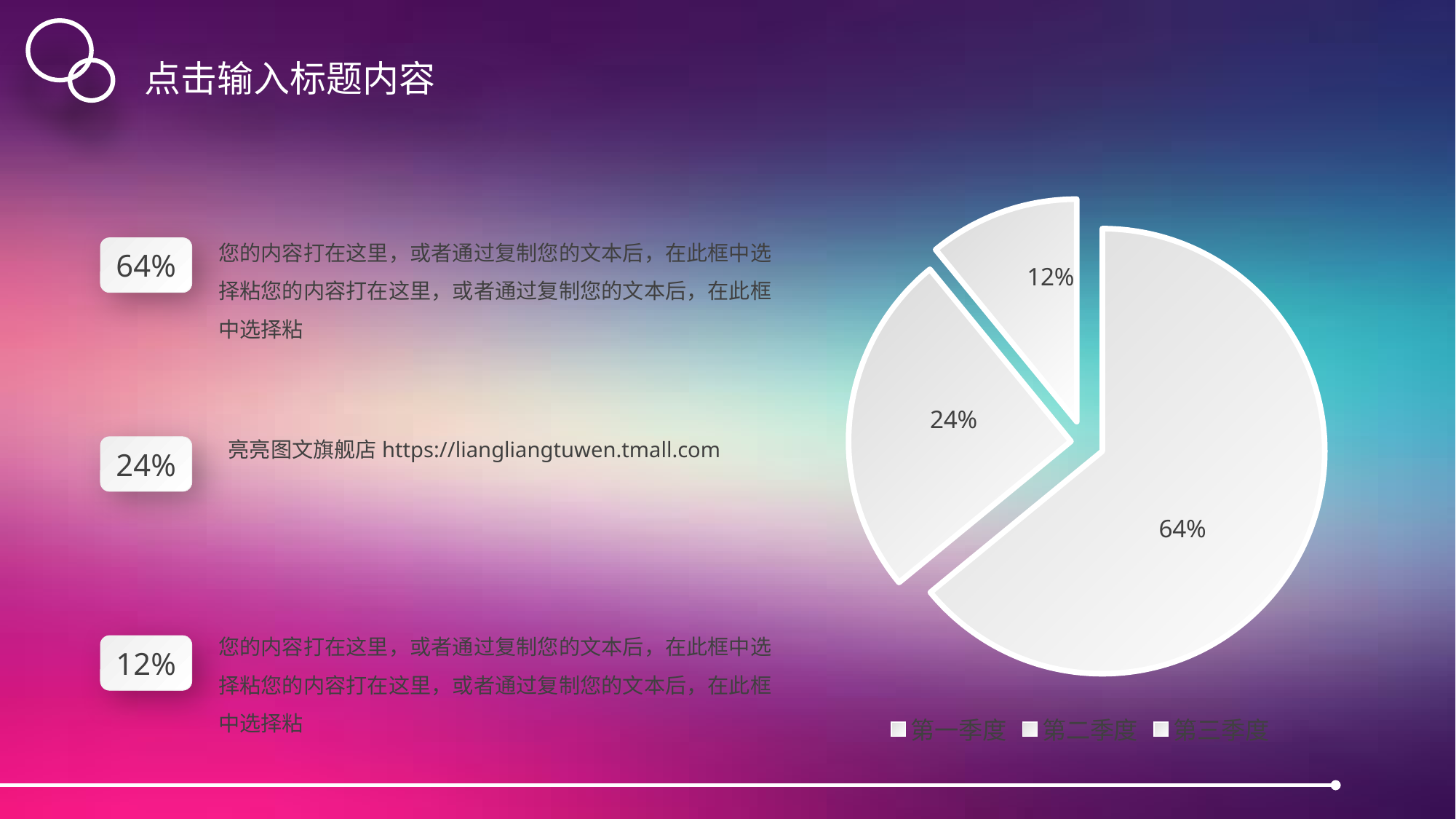
How many entries does the pie chart's legend list? 3 What is the difference between the 64% slice and the 24% slice in the pie chart? 40% What are the three legend entries of the pie chart? 第一季度, 第二季度, 第三季度 What is the difference between the largest and smallest slice values in the pie chart? 52% How many slices does the pie chart have? 3 What is the value shown on the largest slice of the pie chart? 64% What is the value shown on the smallest slice of the pie chart? 12% What kind of chart is shown on the slide? pie chart Is the largest slice of the pie chart more than half of the pie? yes Which is larger in the pie chart, the slice labelled 24% or the slice labelled 12%? 24% What is the total of the three slice values shown on the pie chart? 100%